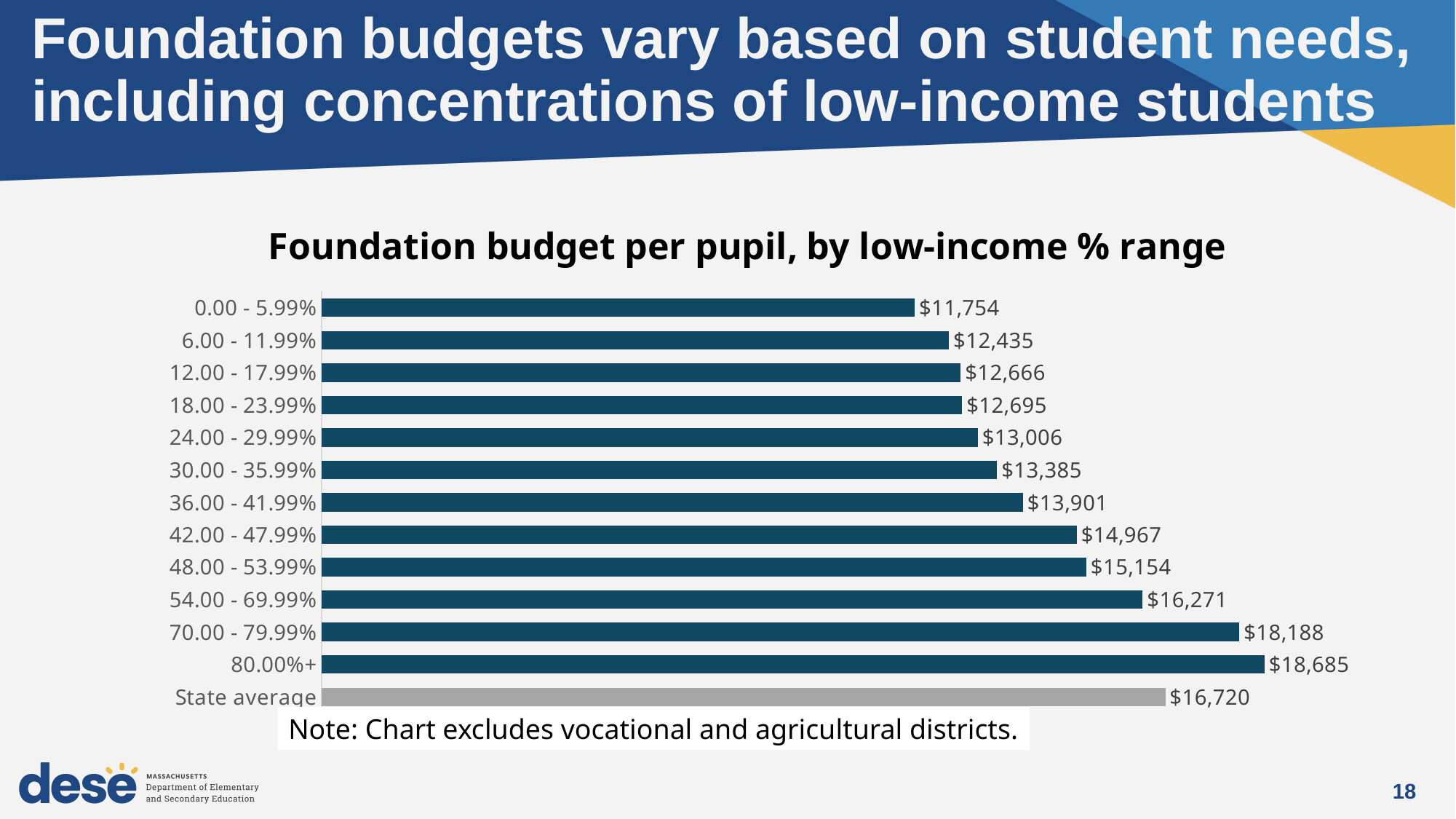
What is the difference between the 70.00 - 79.99% range and the State average? $1,468 Which is larger, the foundation budget per pupil for the 54.00 - 69.99% range or the State average? State average What is the foundation budget per pupil for the 80.00%+ low-income range? $18,685 Which low-income % range has the highest foundation budget per pupil? 80.00%+ What is the foundation budget per pupil for the 42.00 - 47.99% range? $14,967 How many bars are shown on the chart, including the State average? 13 What is the foundation budget per pupil for the 0.00 - 5.99% low-income range? $11,754 What type of chart is shown on the slide? Bar chart What is the State average foundation budget per pupil shown on the chart? $16,720 Do the foundation budget per pupil values rise or fall as the low-income % range increases? Rise What is the difference between the foundation budget per pupil for the 80.00%+ range and the 0.00 - 5.99% range? $6,931 Which low-income % range has the lowest foundation budget per pupil? 0.00 - 5.99%